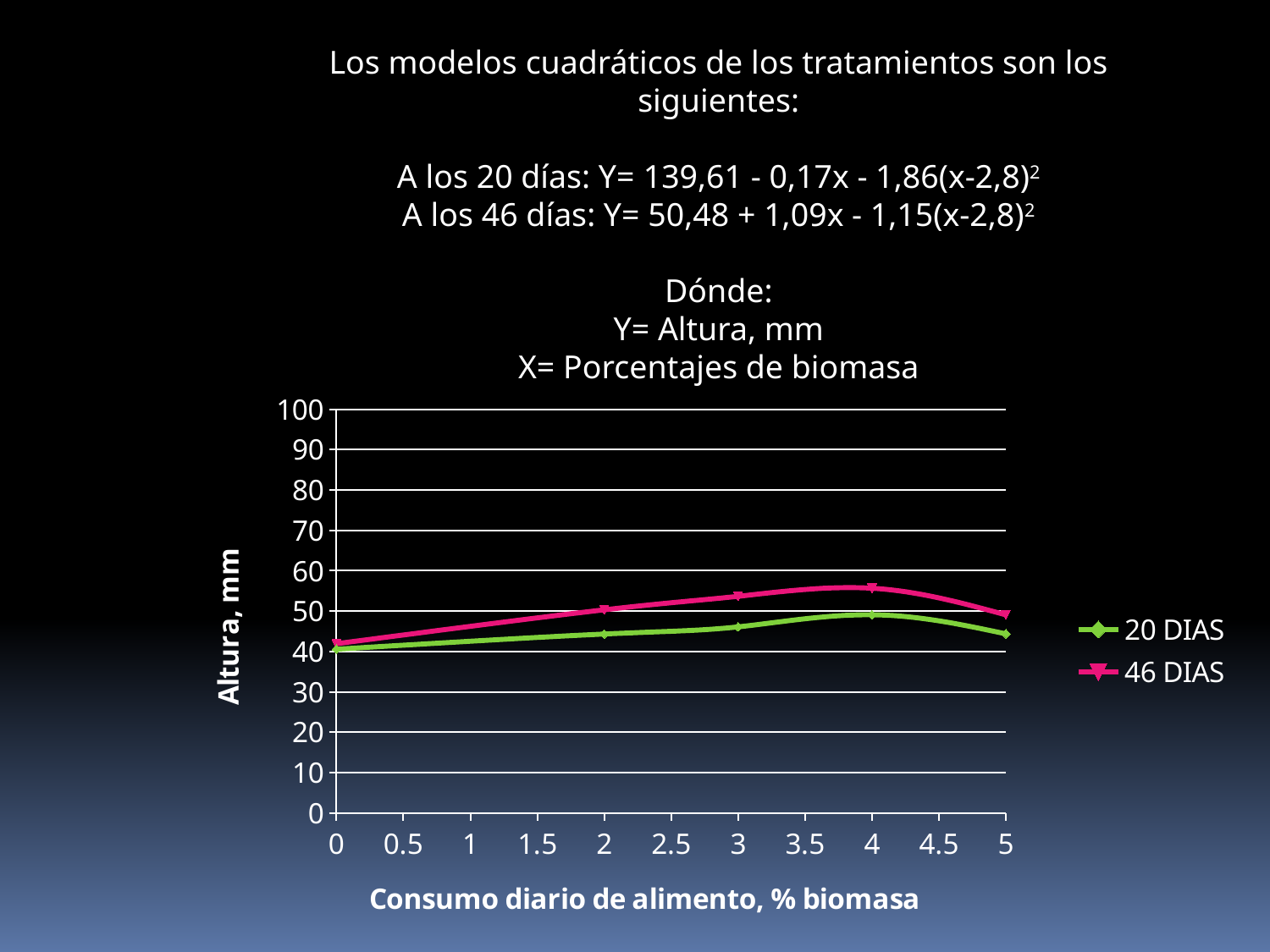
How many data points are plotted for the 46 DIAS series? 5 Does the 46 DIAS series rise or fall between x = 0 and x = 4? rise Is the value for 20 DIAS at x = 3 greater or less than 50? less How many series does the legend list? 2 At which x value is the 46 DIAS series lowest? 0 Is the value for 46 DIAS at x = 5 greater or less than 60? less Is the value for 46 DIAS at x = 4 greater or less than 50? greater At x = 4, which series has the larger value, 20 DIAS or 46 DIAS? 46 DIAS At which x value does the 46 DIAS series reach its highest point? 4 What is the title of the y axis? Altura, mm What kind of chart is shown on the slide? line chart